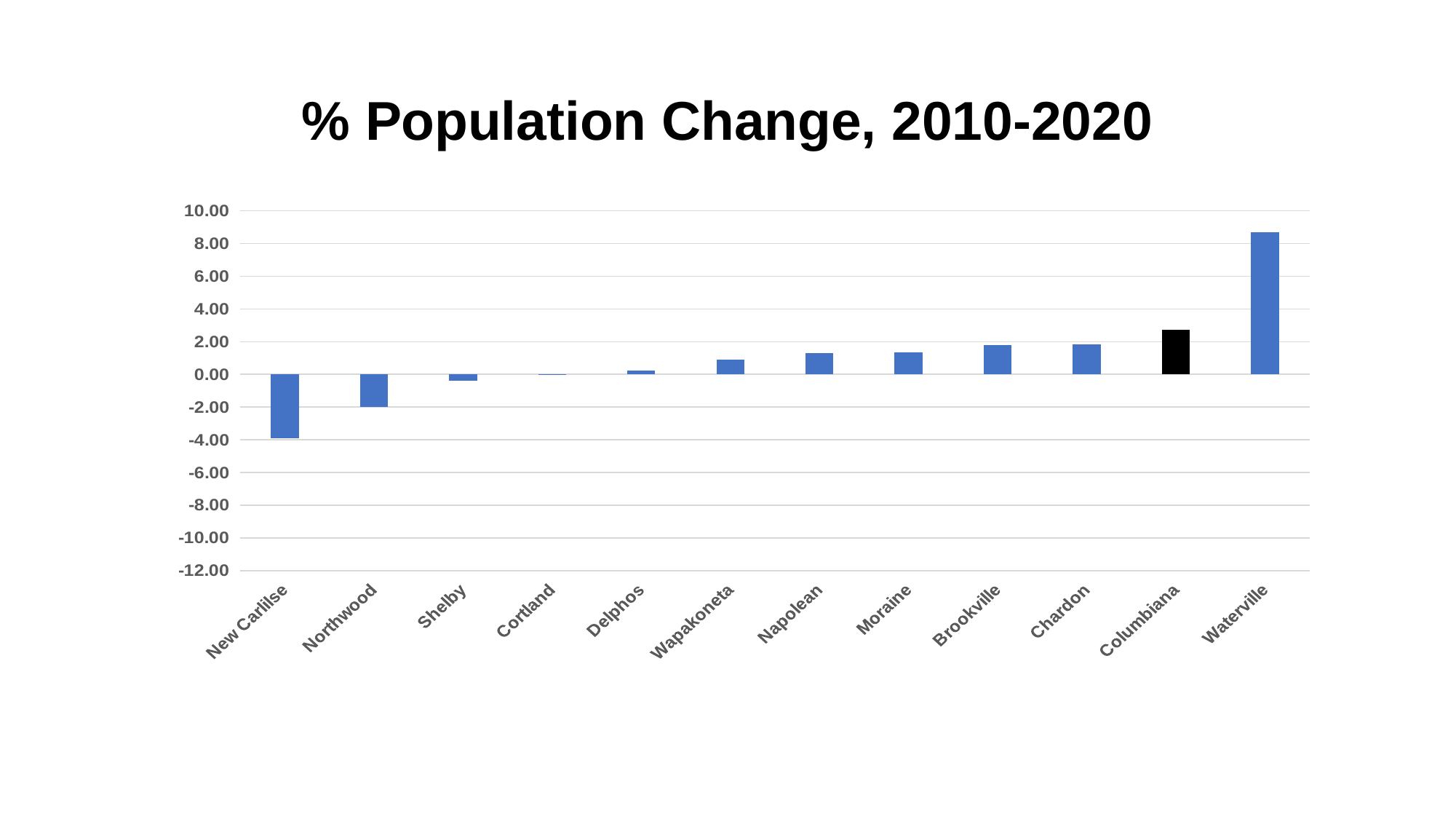
What is the title of the chart? % Population Change, 2010-2020 Do the values generally rise or fall moving from left to right along the x axis? rise Which city has the highest % population change? Waterville Is the value for Brookville greater or less than 2.00? less How many cities are shown on the x axis of the chart? 12 Is the value for New Carlilse greater or less than -2.00? less Is the value for Columbiana greater or less than 2.00? greater Which city has the lowest % population change? New Carlilse Which has a larger % population change, Waterville or Columbiana? Waterville What kind of chart is shown on the slide? bar chart Which city's bar is coloured black rather than blue? Columbiana